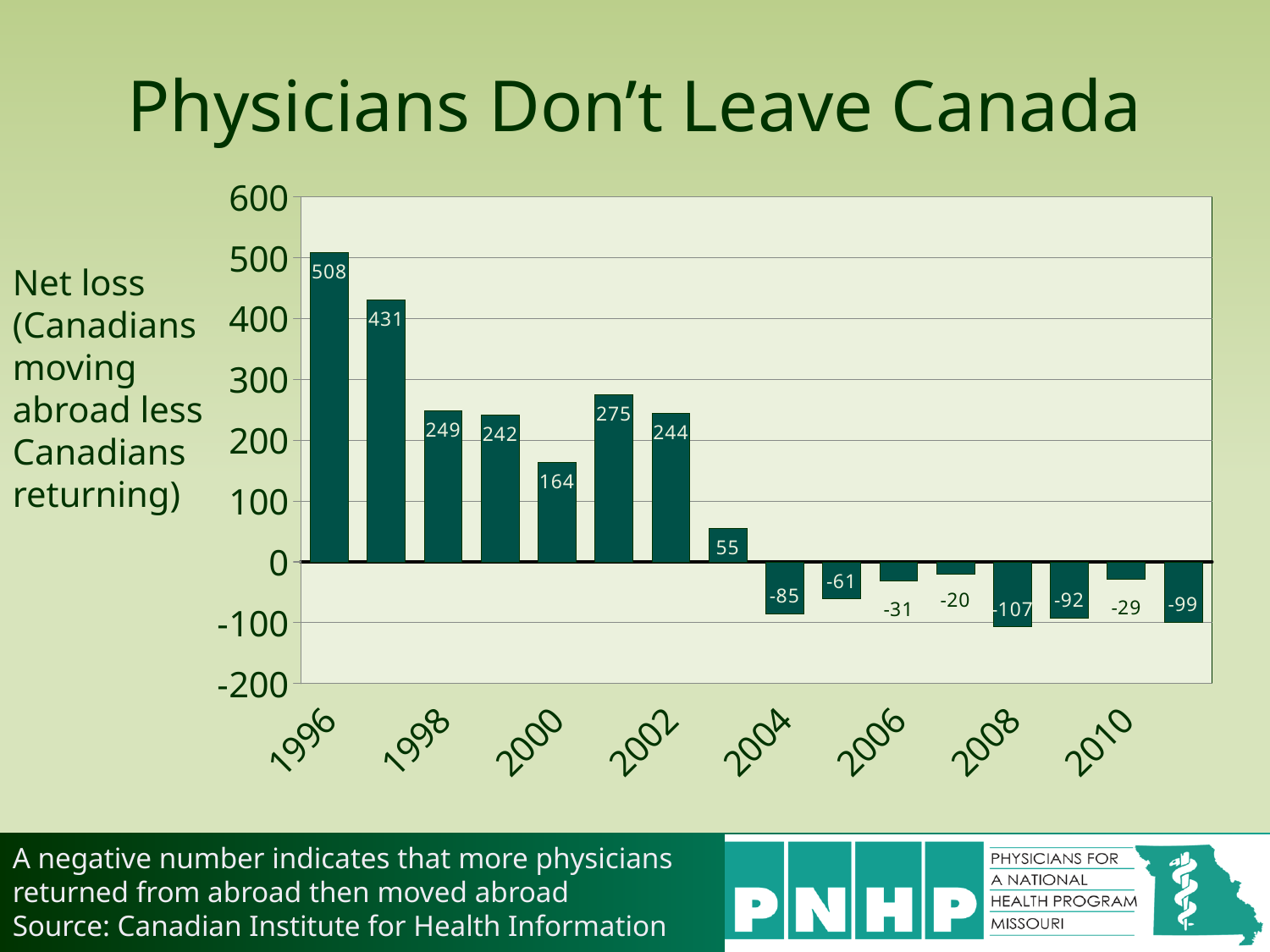
What is the value shown for 2008? -107 What is the difference between the values for 1996 and 1998? 259 What kind of chart is shown on the slide? bar chart Which year has the highest net loss value? 1996 Which year has the lowest value on the chart? 2008 What is the value shown for 2000? 164 How many bars are plotted on the chart? 16 What is the net loss value for 1996? 508 What is the value shown for 2010? -29 Is the value for 2004 greater or less than 0? less Which is larger, the value for 2002 or the value for 2000? 2002 Do the values generally rise or fall from 1996 to 2010? fall